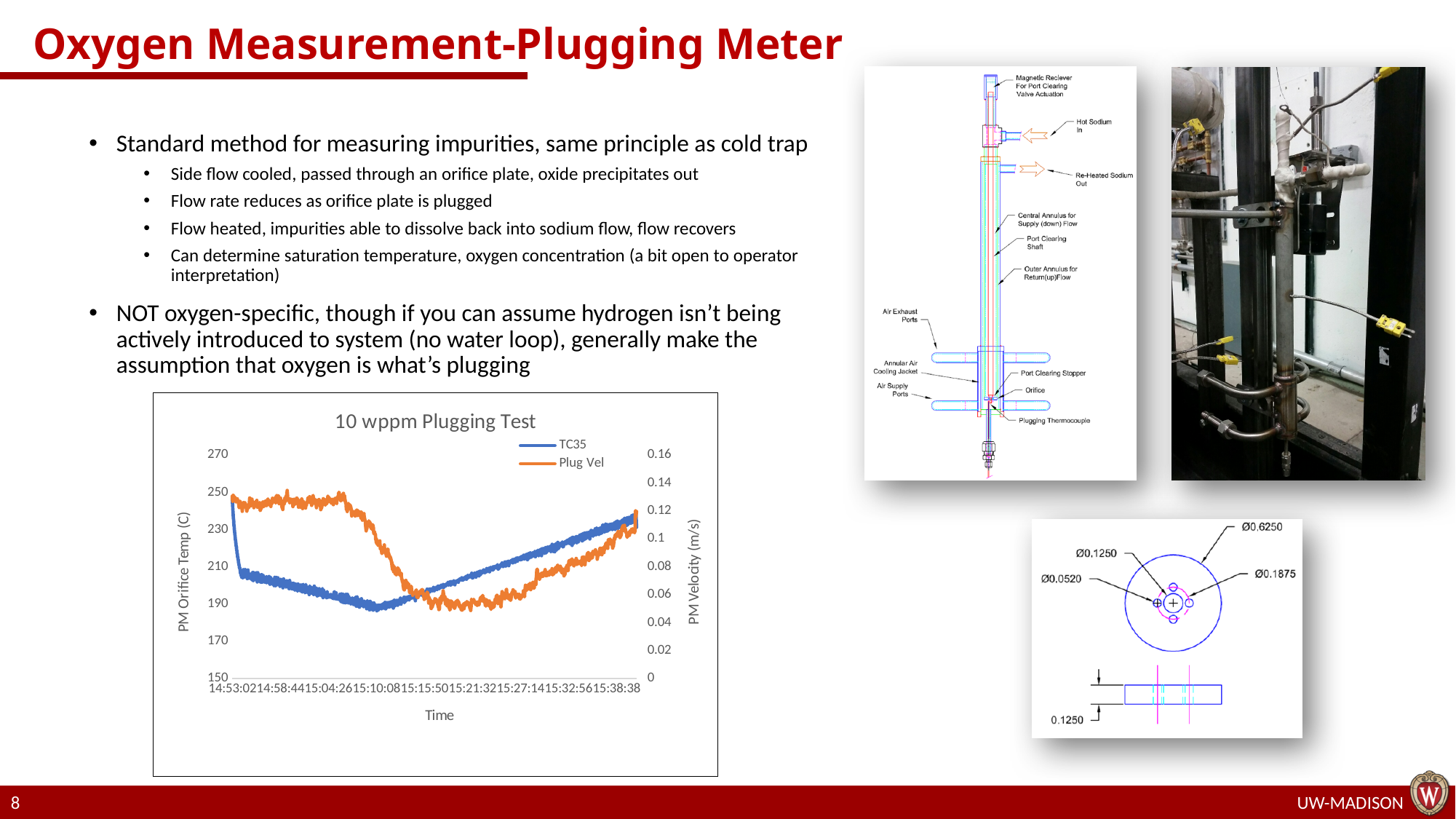
What is the title of the chart on the slide? 10 wppm Plugging Test In the 10 wppm Plugging Test chart, is the lowest Plug Vel value greater or less than 0.08? less In the 10 wppm Plugging Test chart, is the lowest TC35 value greater or less than 210? less How many series does the legend of the 10 wppm Plugging Test chart list? 2 In the 10 wppm Plugging Test chart, is the Plug Vel value at the start of the test greater or less than 0.1? greater In the 10 wppm Plugging Test chart, does the TC35 series rise or fall between 14:53:02 and 15:10:08? fall How many time labels are shown along the x axis of the 10 wppm Plugging Test chart? 9 What kind of chart is the 10 wppm Plugging Test chart? line chart In the 10 wppm Plugging Test chart, does the Plug Vel series rise or fall between 15:21:32 and 15:38:38? rise In the 10 wppm Plugging Test chart, does the TC35 series rise or fall between 15:15:50 and 15:38:38? rise What are the two series named in the legend of the 10 wppm Plugging Test chart? TC35 and Plug Vel